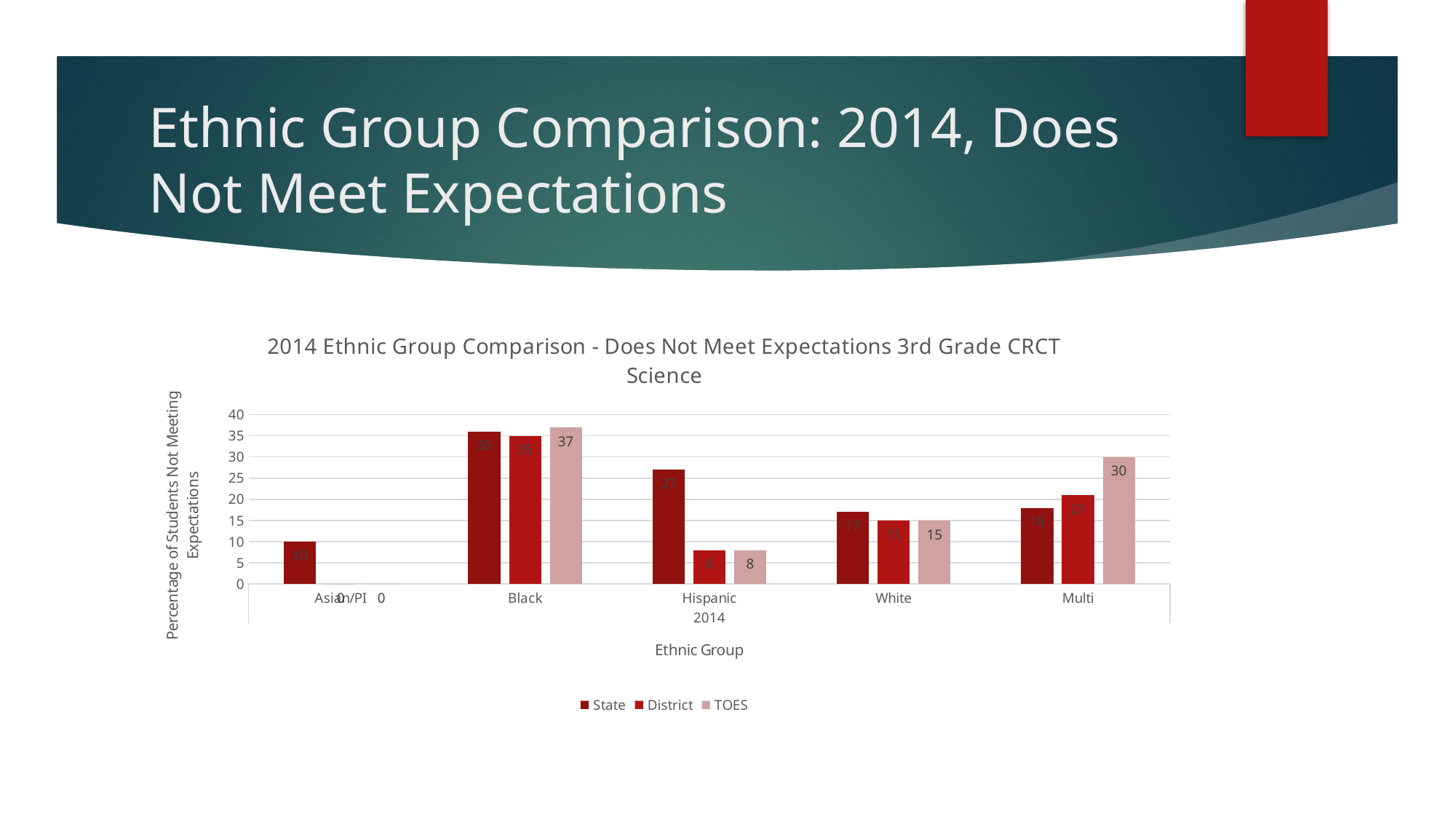
What is the TOES value for Multi? 30 What is the label of the y axis? Percentage of Students Not Meeting Expectations Which ethnic group has the lowest State value? Asian/PI Which is larger for Hispanic, the State value or the District value? State Which ethnic group has the highest TOES value? Black What is the District value for White? 15 What is the TOES value for Black? 37 How many ethnic groups are shown on the x axis? 5 What is the difference between the TOES value and the District value for Multi? 9 How many series does the legend list? 3 What kind of chart is shown on the slide? Bar chart What is the State value for Hispanic? 27